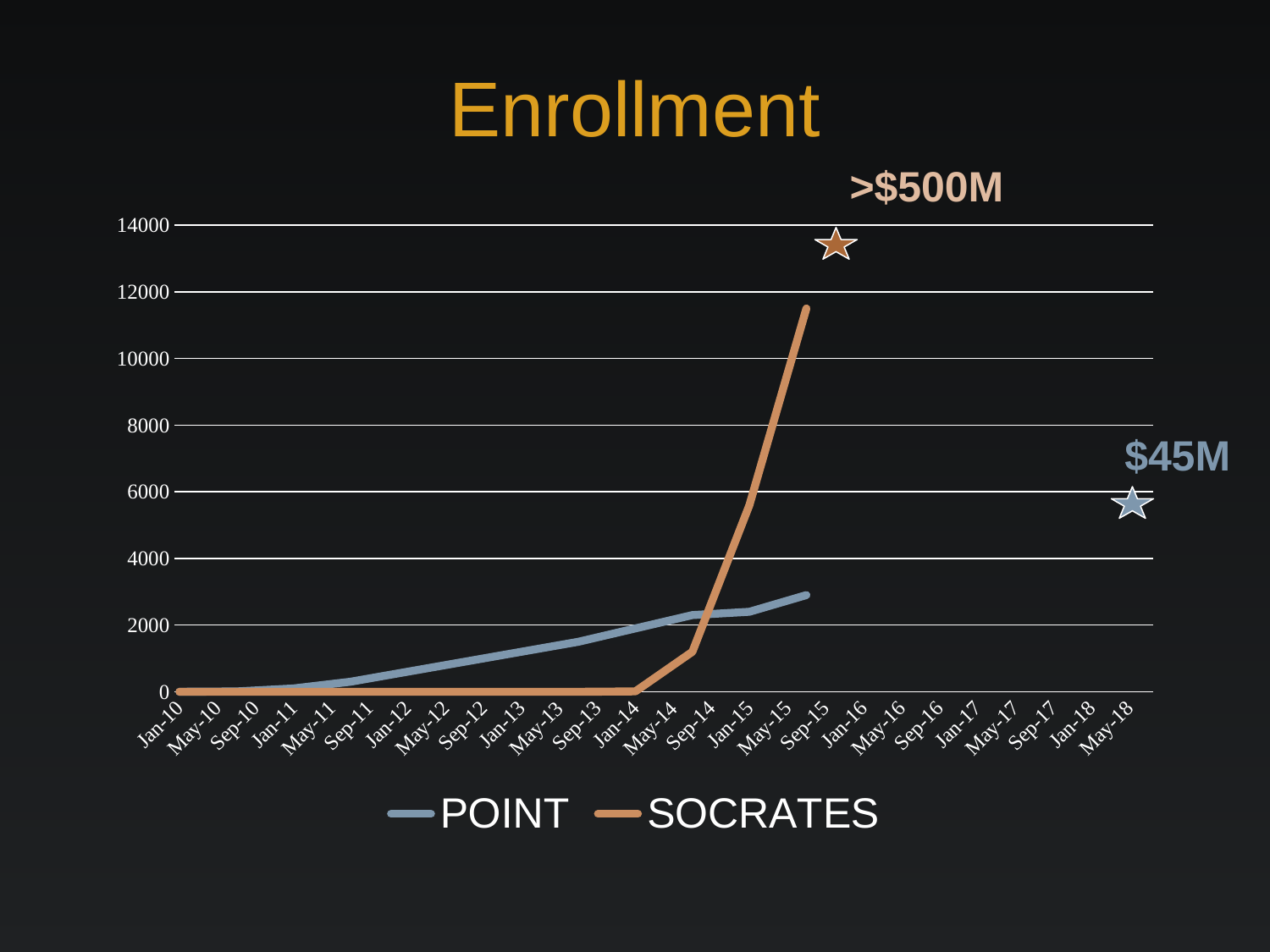
Does the SOCRATES line rise or fall from Jan-14 to its final point? rise Is the highest value reached by the SOCRATES line greater or less than 12000? less How many date labels are shown along the x axis? 26 What is the title of the chart? Enrollment Which series reaches the higher enrollment value on the chart? SOCRATES What kind of chart is shown on the slide? line chart At the final plotted point, which series has the larger value, POINT or SOCRATES? SOCRATES How many series does the legend list? 2 Is the value of the POINT line at Jan-12 greater or less than 2000? less Is the highest value reached by the SOCRATES line greater or less than 10000? greater Which two series are listed in the legend? POINT and SOCRATES